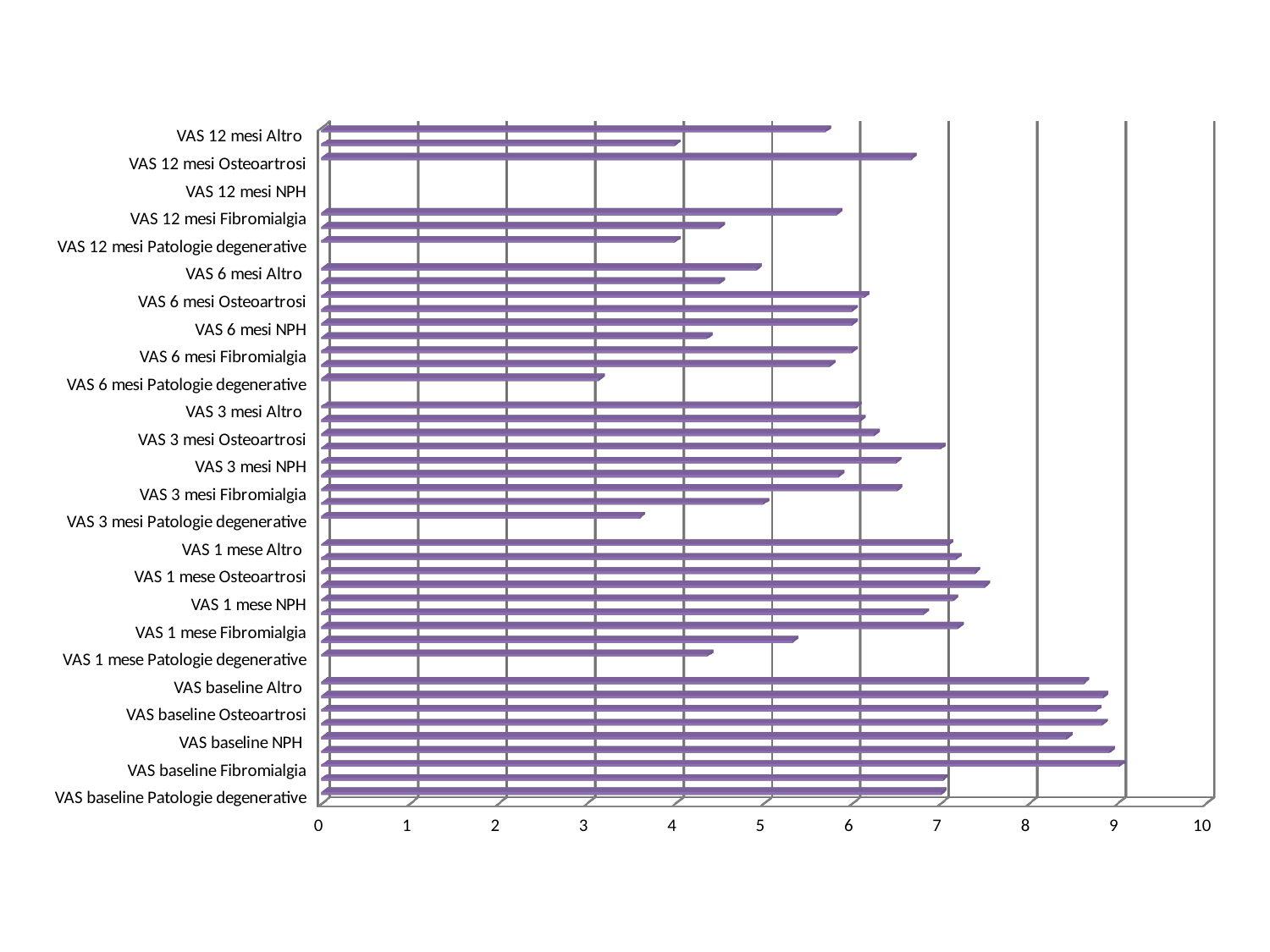
Is the value for VAS 1 mese Osteoartrosi greater or less than 7? greater Is the value for VAS baseline Altro greater or less than 8? greater Is the value for VAS baseline Fibromialgia greater or less than 8? greater What is the maximum value shown on the horizontal axis? 10 Which is larger, the value for VAS baseline Fibromialgia or the value for VAS 6 mesi Patologie degenerative? VAS baseline Fibromialgia Which is larger, the value for VAS baseline Osteoartrosi or the value for VAS 12 mesi Osteoartrosi? VAS baseline Osteoartrosi What kind of chart is shown on the slide? bar chart